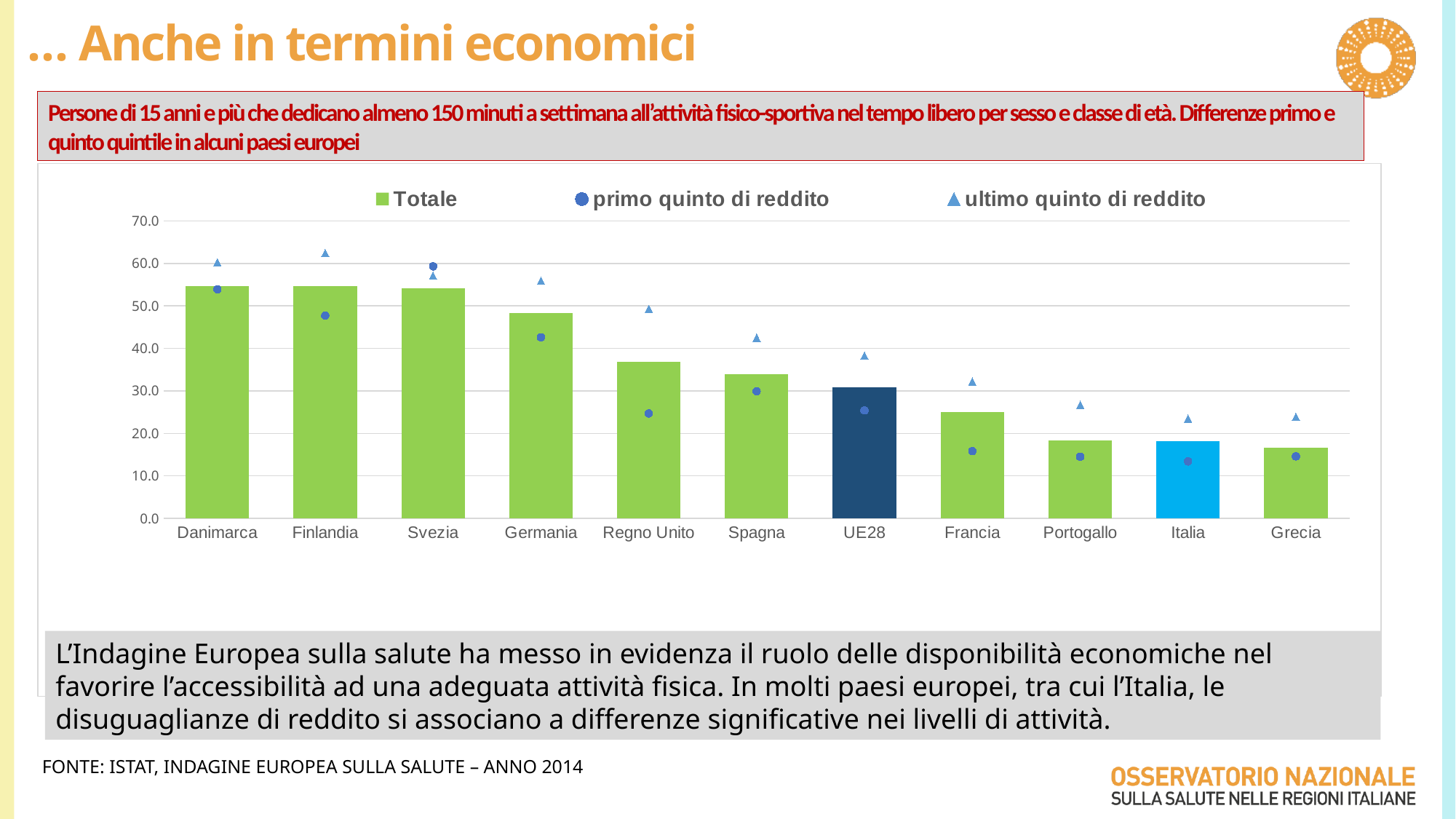
Is the Totale value for Italia greater or less than 20? less Is the Totale value for UE28 greater or less than 40? less Which category has the lowest Totale bar? Grecia What colour is the Italia bar in the chart? light blue Is the Totale value for Danimarca greater or less than 50? greater How many countries/categories are shown on the x axis of the chart? 11 What kind of chart is shown on the slide? bar chart Which has the larger Totale bar, Germania or Regno Unito? Germania Do the Totale bars rise or fall from left to right along the x axis? fall How many series does the chart legend list? 3